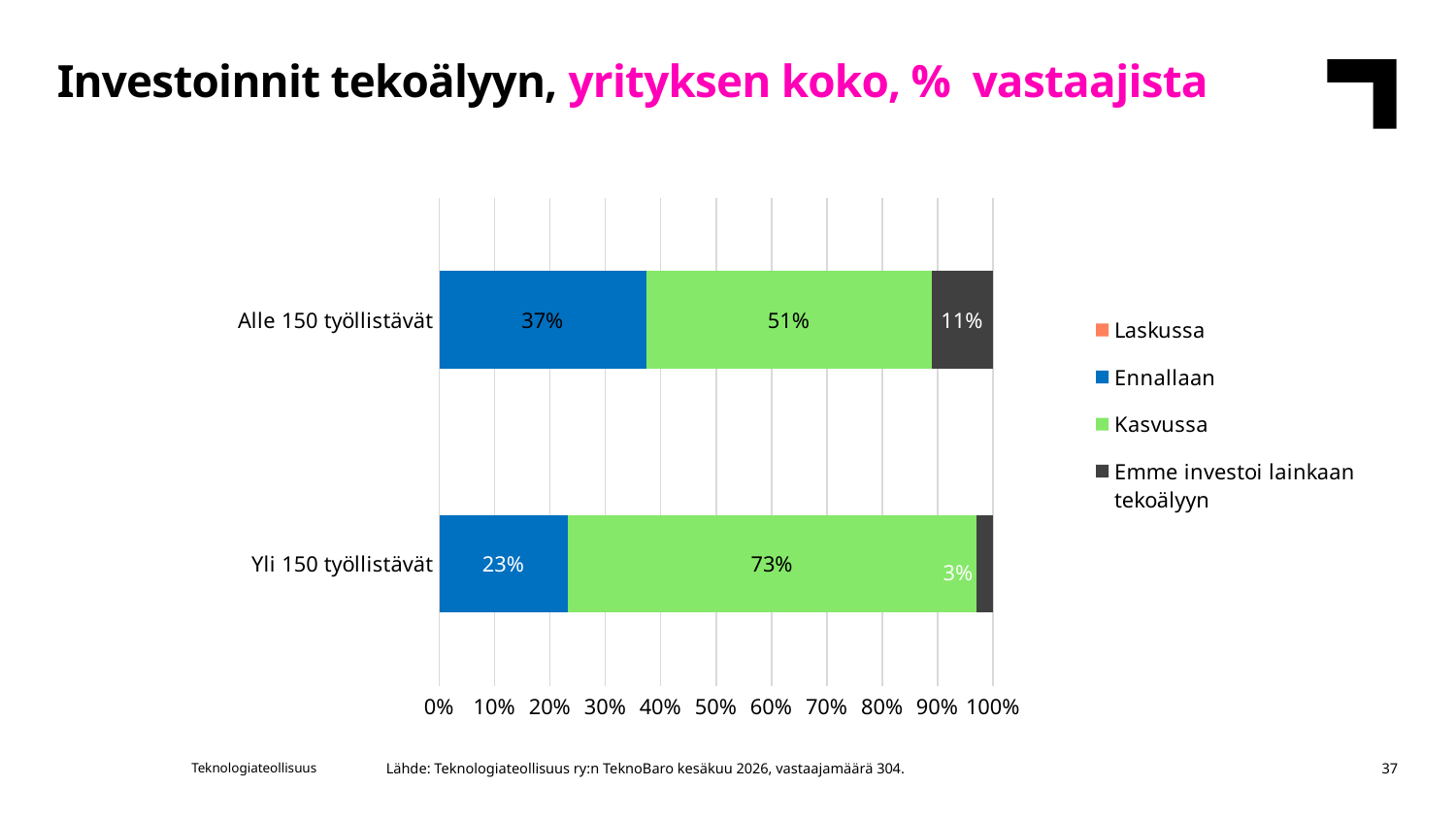
What is the Emme investoi lainkaan tekoälyyn value for Yli 150 työllistävät? 3% How many categories are shown on the y axis? 2 Which category has the higher Kasvussa value? Yli 150 työllistävät What is the Kasvussa value for Yli 150 työllistävät? 73% What is the Emme investoi lainkaan tekoälyyn value for Alle 150 työllistävät? 11% How many series does the legend list? 4 What is the difference between the Kasvussa values for Yli 150 työllistävät and Alle 150 työllistävät? 22% What kind of chart is shown on the slide? stacked bar chart Which category has the lower Ennallaan value? Yli 150 työllistävät Which legend entry is shown in green? Kasvussa What is the Ennallaan value for Alle 150 työllistävät? 37% Is the Ennallaan value for Alle 150 työllistävät larger or smaller than the Ennallaan value for Yli 150 työllistävät? larger